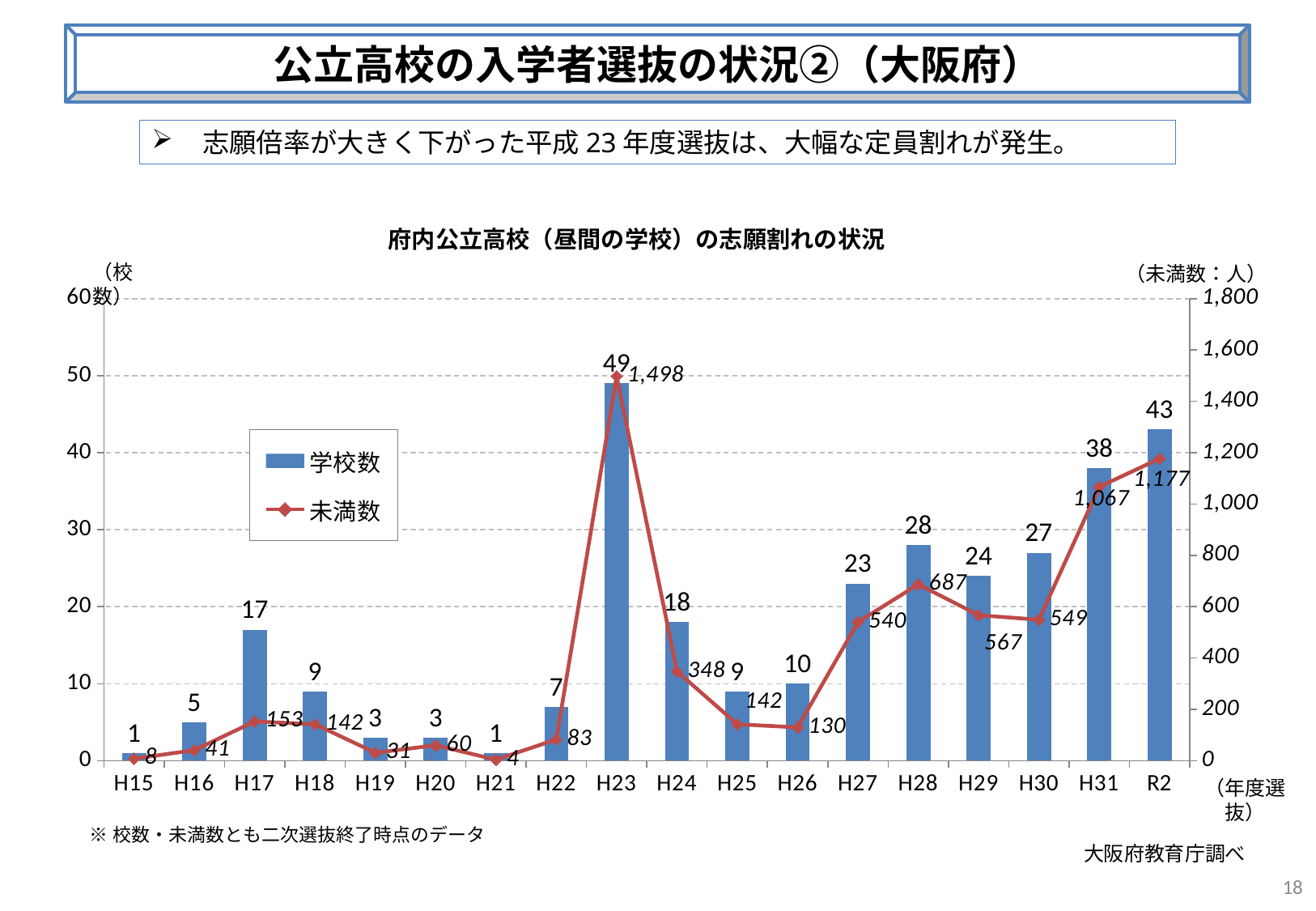
Which year has the highest 未満数? H23 How many years (categories) are shown on the x axis? 18 What is the 未満数 value for R2? 1,177 Which is larger, the 学校数 for H27 or for H29? H29 What kind of chart is used to show 学校数? bar chart What is the title of the chart? 府内公立高校（昼間の学校）の志願割れの状況 How many series does the legend list? 2 What is the 未満数 value for H28? 687 Which year has the lowest 未満数? H21 What is the difference in 学校数 between R2 and H31? 5 What is the difference in 未満数 between H23 and H24? 1,150 What is the 学校数 value for H23? 49